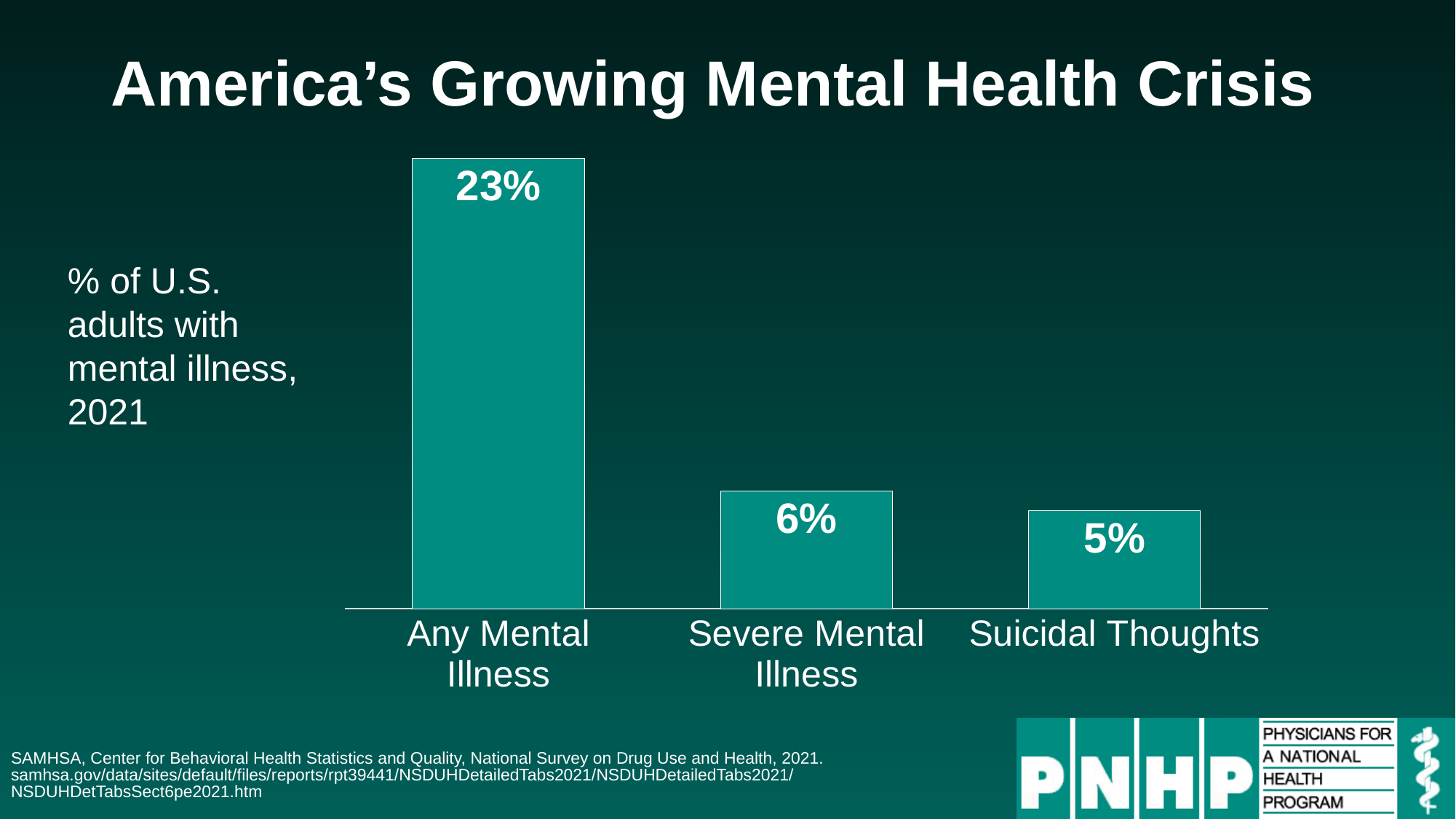
What is the title of the slide containing the chart? America's Growing Mental Health Crisis What kind of chart is shown on the slide? Bar chart How many categories are shown in the chart? 3 What is the difference between the values for Severe Mental Illness and Suicidal Thoughts? 1% What percentage of U.S. adults had any mental illness in 2021 according to the chart? 23% Do the values rise or fall from left to right across the categories? Fall Which is larger, the value for Any Mental Illness or the value for Suicidal Thoughts? Any Mental Illness Which category has the lowest value in the chart? Suicidal Thoughts What is the value shown for Suicidal Thoughts? 5% Which category has the highest value in the chart? Any Mental Illness What is the value shown for Severe Mental Illness? 6% What is the difference between the values for Any Mental Illness and Severe Mental Illness? 17%